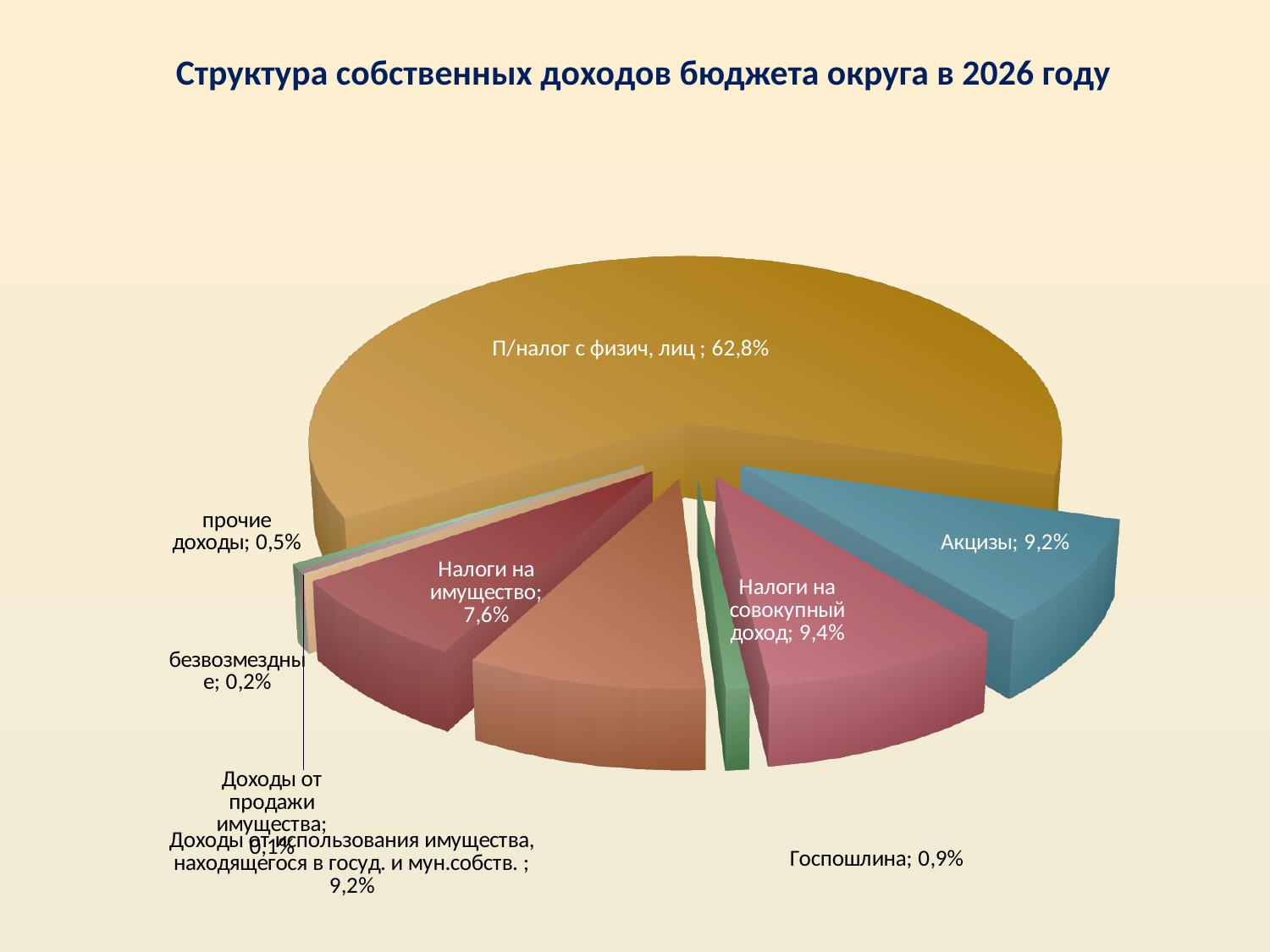
Which category has the largest share of the pie? П/налог с физич, лиц What kind of chart is shown on the slide? Pie chart What is the value shown for "Акцизы"? 9,2% What is the difference between the shares of "Налоги на совокупный доход" and "Акцизы"? 0,2% Which is larger: "Налоги на совокупный доход" or "Налоги на имущество"? Налоги на совокупный доход What is the title of the chart? Структура собственных доходов бюджета округа в 2026 году What is the value shown for "Налоги на имущество"? 7,6% What is the value shown for "Налоги на совокупный доход"? 9,4% How many categories are shown in the pie chart? 10 What is the value shown for "Госпошлина"? 0,9% What share of the pie is labelled for "П/налог с физич, лиц"? 62,8%